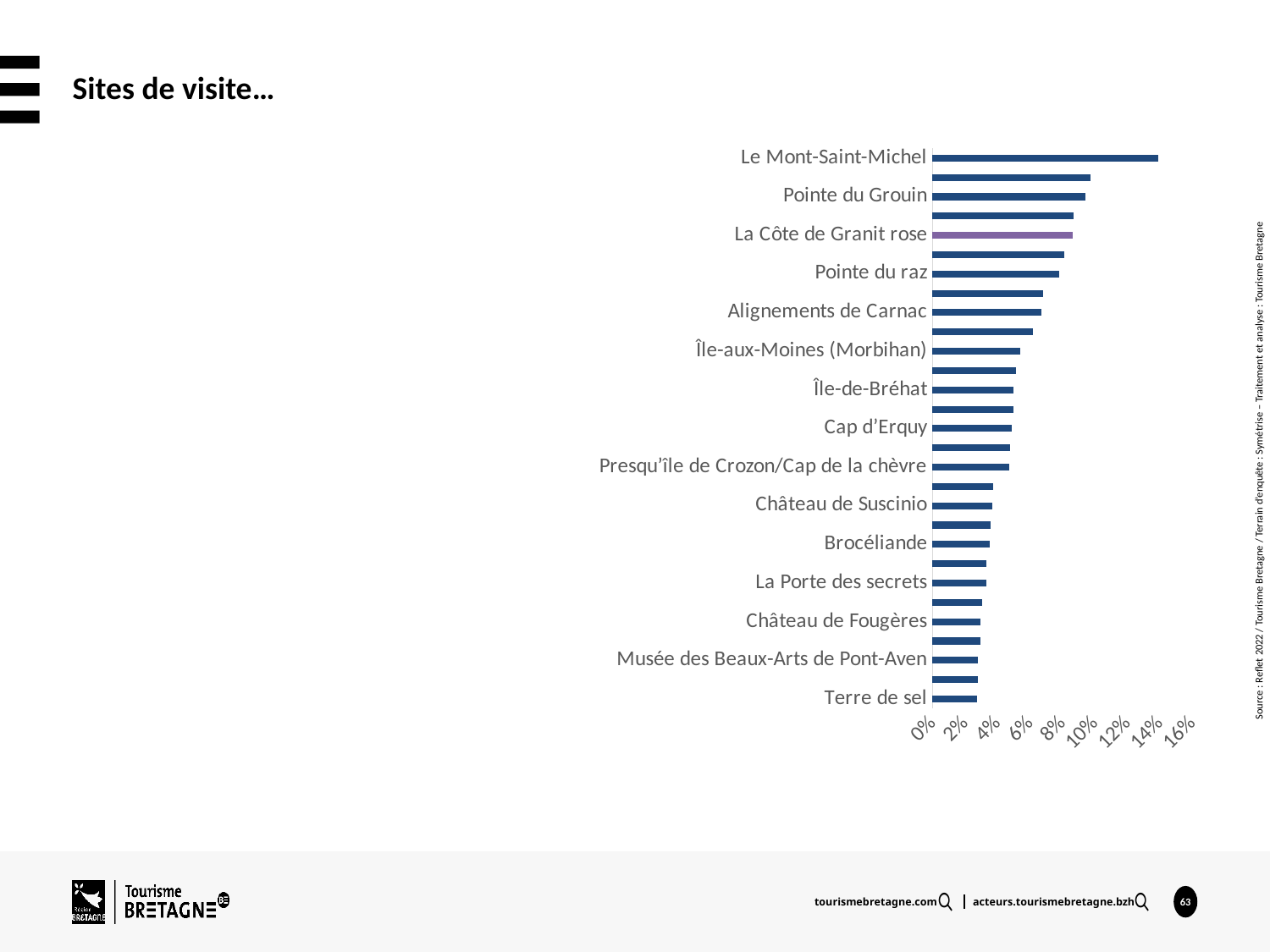
Which has the larger value, Le Mont-Saint-Michel or Pointe du Grouin? Le Mont-Saint-Michel Is the value for Terre de sel greater or less than 4%? less Which site's bar is highlighted in a different colour (purple) from the others? La Côte de Granit rose Is the value for Pointe du Grouin greater or less than 8%? greater What is the title of the slide containing the chart? Sites de visite… Is the value for Château de Suscinio greater or less than 6%? less Do the bar values increase or decrease going from the top of the chart to the bottom? decrease Which has the larger value, Pointe du raz or Château de Suscinio? Pointe du raz What kind of chart is shown on the slide? Bar chart Which site has the highest value in the chart? Le Mont-Saint-Michel